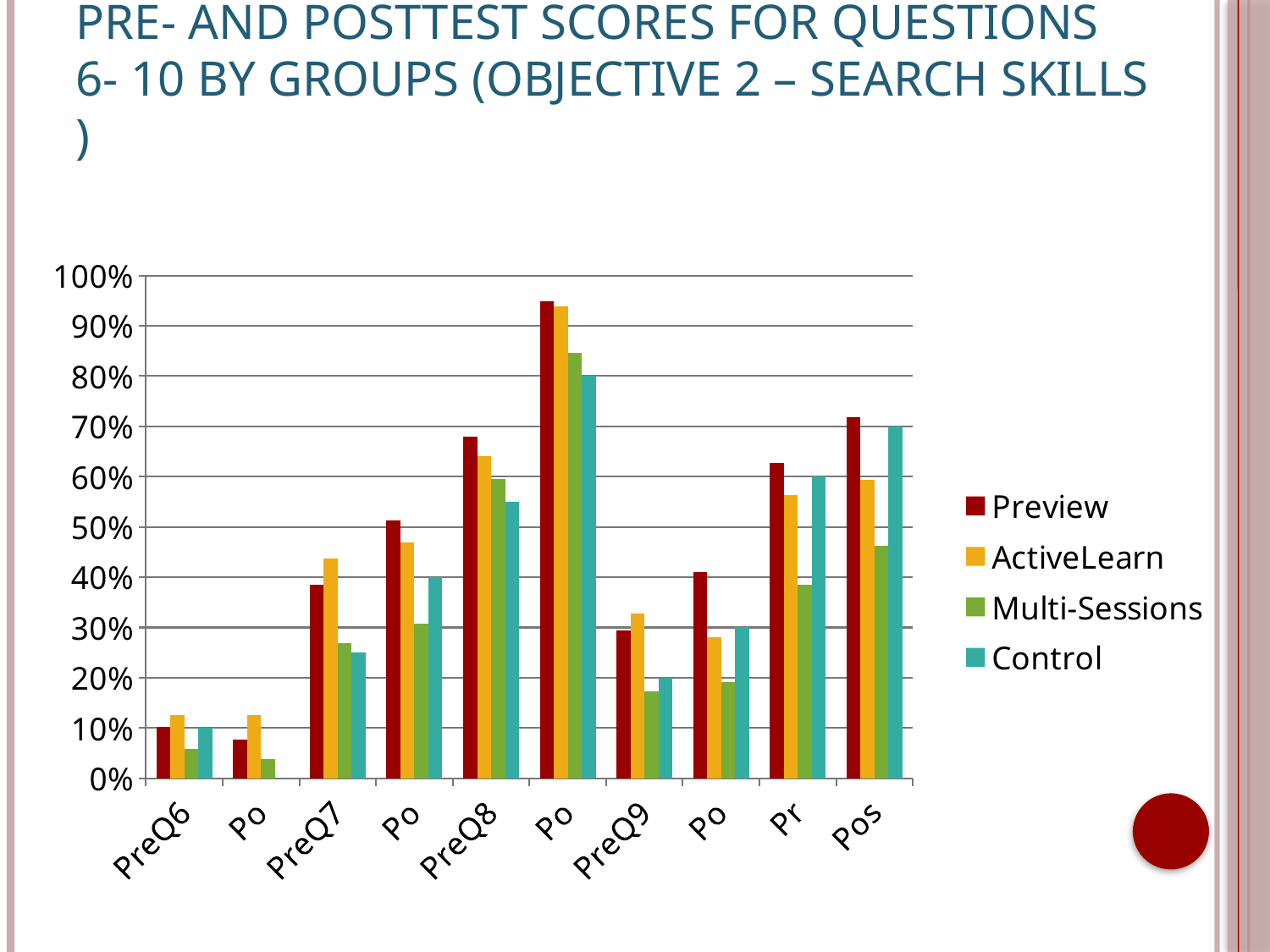
Is the Preview value for PreQ8 greater or less than 70%? less Which series has the highest value in the PreQ7 category? ActiveLearn Which series has the lowest value in the Pr category? Multi-Sessions Which series are listed in the legend? Preview, ActiveLearn, Multi-Sessions, Control In the PreQ8 category, which is larger: the ActiveLearn value or the Control value? ActiveLearn How many series does the legend list? 4 Which series is shown in dark red? Preview Is the ActiveLearn value for PreQ7 greater or less than 40%? greater How many categories are shown along the x axis? 10 What kind of chart is shown on the slide? bar chart Is the Multi-Sessions value for PreQ9 greater or less than 20%? less